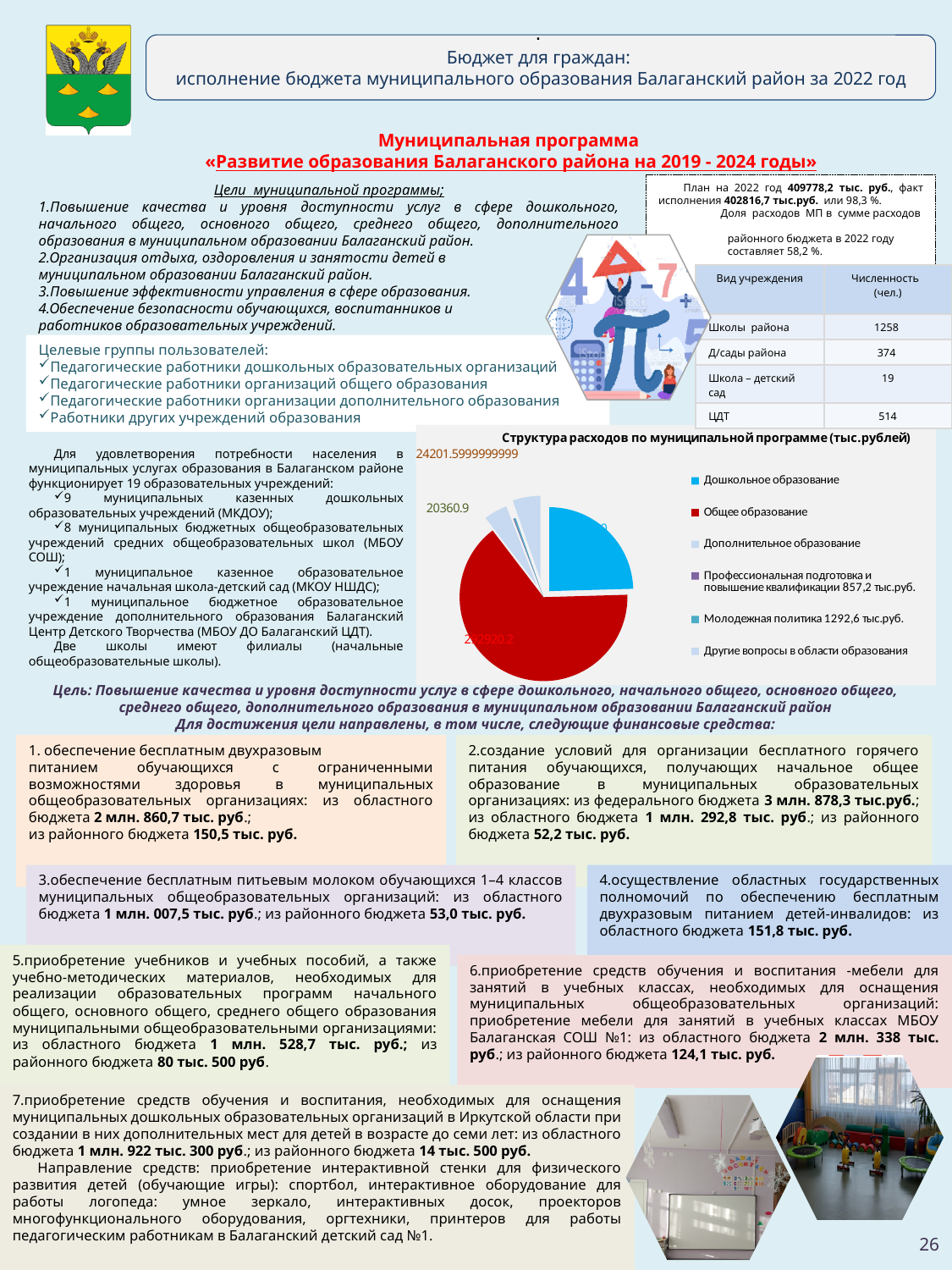
In the pie chart 'Структура расходов по муниципальной программе', which is larger: 'Молодежная политика' or 'Профессиональная подготовка и повышение квалификации'? Молодежная политика What is the title of the pie chart on the slide? Структура расходов по муниципальной программе (тыс.рублей) What kind of chart is used for 'Структура расходов по муниципальной программе (тыс.рублей)'? pie chart In the pie chart 'Структура расходов по муниципальной программе', what value is labelled on the 'Общее образование' slice? 292920.2 In the pie chart 'Структура расходов по муниципальной программе', what is the difference between 'Молодежная политика' (1292,6 тыс.руб.) and 'Профессиональная подготовка и повышение квалификации' (857,2 тыс.руб.)? 435,4 тыс.руб. According to the legend of the pie chart 'Структура расходов по муниципальной программе', what is the amount for 'Профессиональная подготовка и повышение квалификации'? 857,2 тыс.руб. How many categories does the legend of the pie chart 'Структура расходов по муниципальной программе' list? 6 According to the legend of the pie chart 'Структура расходов по муниципальной программе', what is the amount for 'Молодежная политика'? 1292,6 тыс.руб. Which category has the largest slice in the pie chart 'Структура расходов по муниципальной программе'? Общее образование In the pie chart 'Структура расходов по муниципальной программе', which slice is larger: 'Общее образование' or 'Дошкольное образование'? Общее образование In the pie chart 'Структура расходов по муниципальной программе', what colour represents 'Общее образование'? red